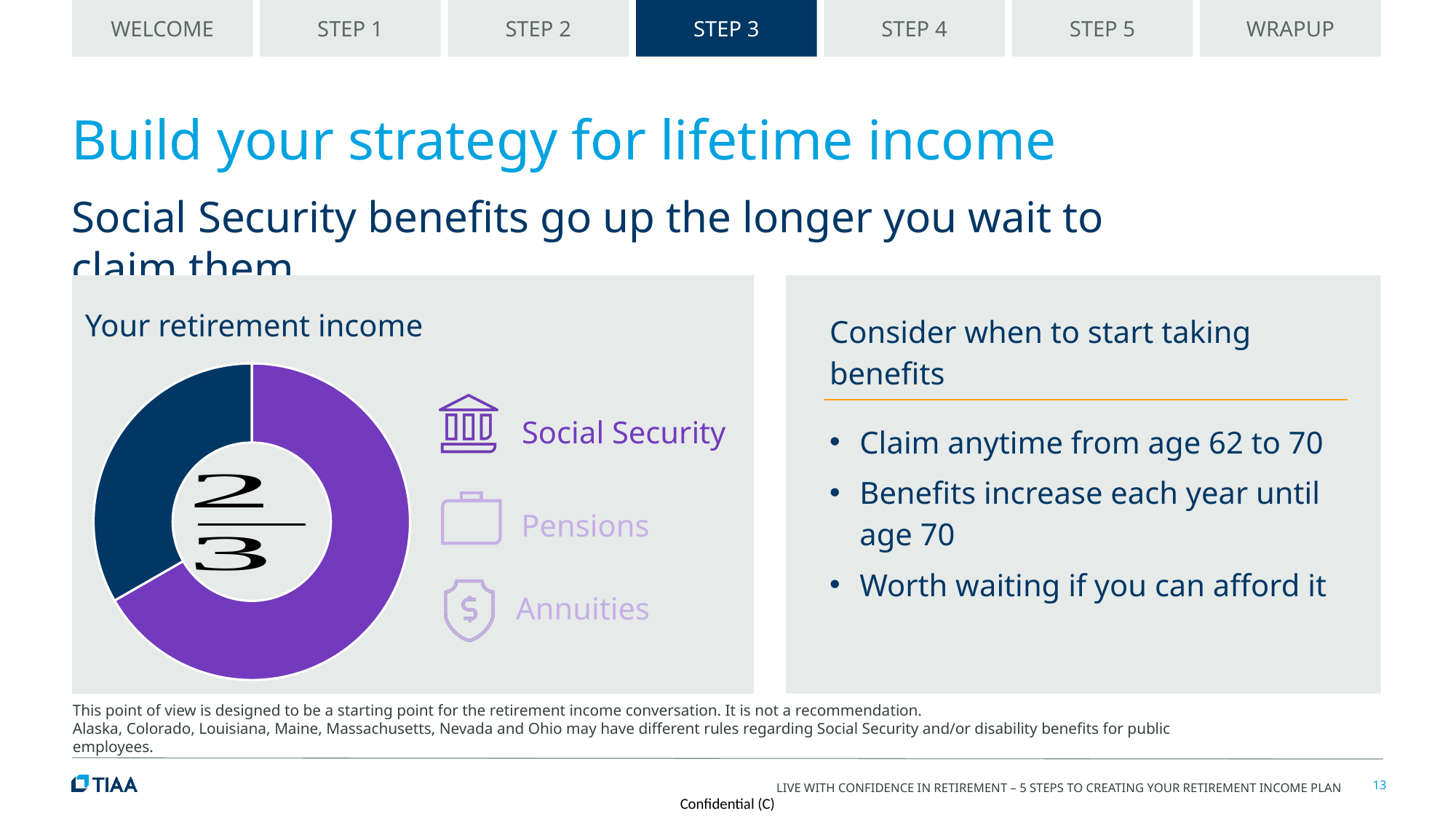
What fraction is printed in the center of the donut chart? 2/3 Which slice of the donut chart is larger, the purple slice or the dark navy slice? The purple slice Which income source occupies the largest portion of the donut chart? Social Security What share of retirement income does the Social Security slice represent in the donut chart? 2/3 What kind of chart is shown under "Your retirement income"? Pie chart (donut) What is the title of the chart on the left side of the slide? Your retirement income How many slices does the donut chart have? 2 Which income source is shown in purple in the donut chart? Social Security